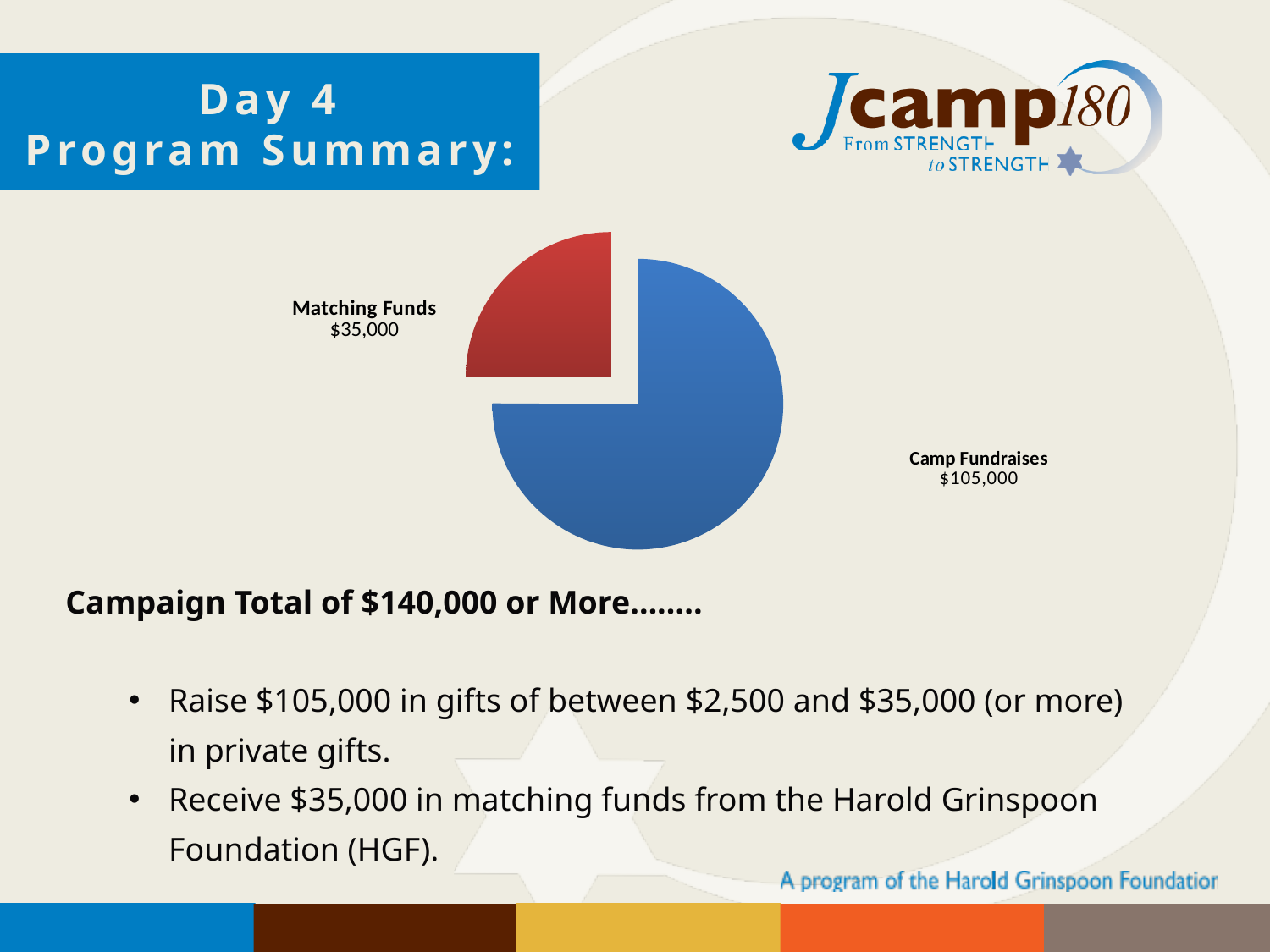
What share of the pie chart does Camp Fundraises represent? 75% Which is larger in the pie chart, Matching Funds or Camp Fundraises? Camp Fundraises What is the value for Camp Fundraises in the pie chart? $105,000 What is the difference between Camp Fundraises and Matching Funds in the pie chart? $70,000 What is the value for Matching Funds in the pie chart? $35,000 Which slice of the pie chart is the largest? Camp Fundraises What share of the pie chart does Matching Funds represent? 25% What kind of chart is shown on the slide? Pie chart How many slices does the pie chart have? 2 Which slice of the pie chart is the smallest? Matching Funds What colour is the Matching Funds slice in the pie chart? Red What is the total of the two slices in the pie chart? $140,000